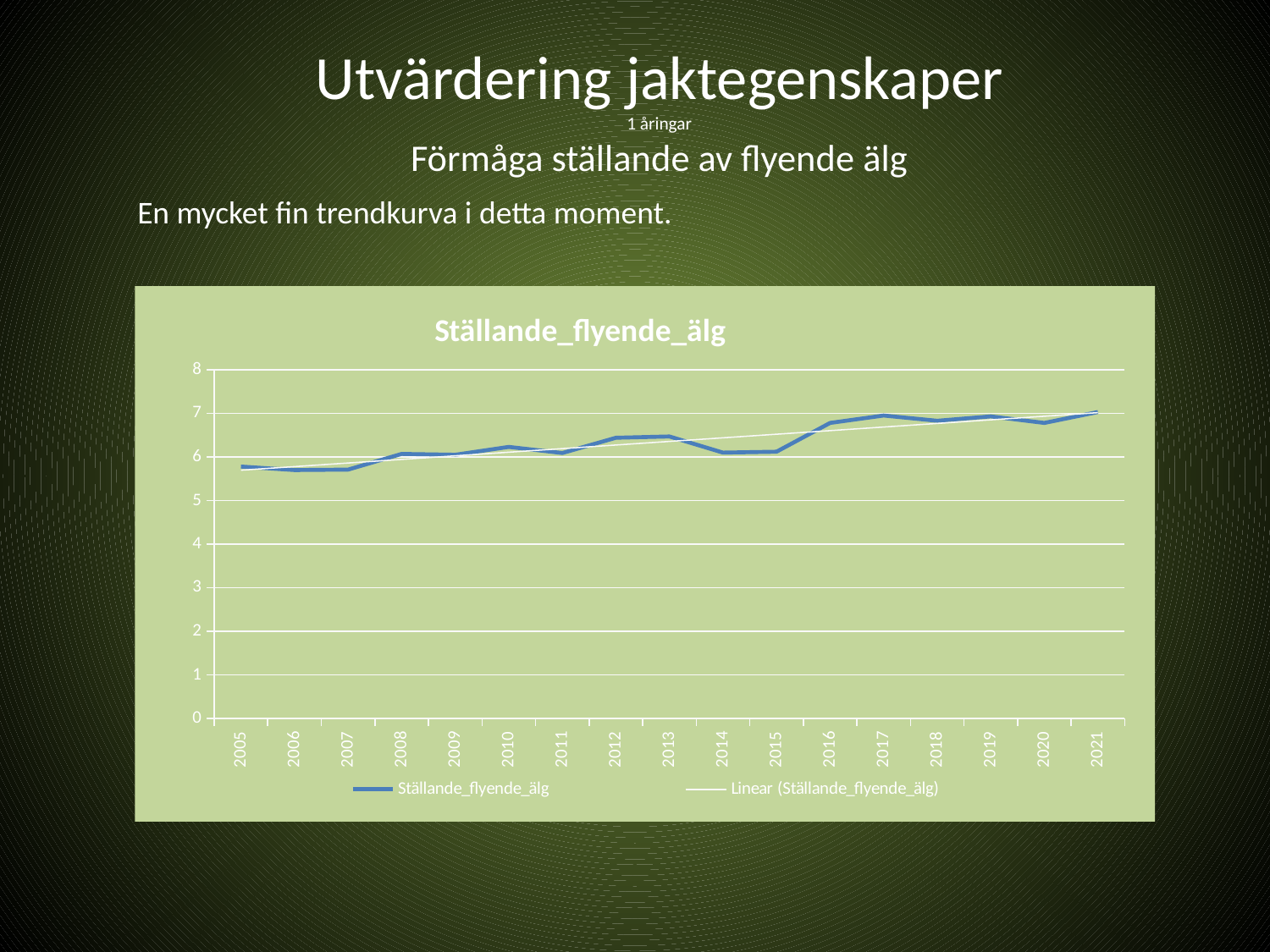
How many entries does the chart legend list? 2 Is the value for Ställande_flyende_älg in 2006 greater or less than 6? less Is the value for Ställande_flyende_älg in 2005 greater or less than 6? less Which year has the larger value for Ställande_flyende_älg, 2006 or 2012? 2012 Which year has the larger value for Ställande_flyende_älg, 2005 or 2016? 2016 How many years are plotted along the x axis of the chart? 17 What is the title of the chart? Ställande_flyende_älg Is the value for Ställande_flyende_älg in 2012 greater or less than 6? greater Do the values for Ställande_flyende_älg generally rise or fall from 2005 to 2021? rise What is the first year shown on the x axis of the chart? 2005 What kind of chart is shown on the slide? line chart